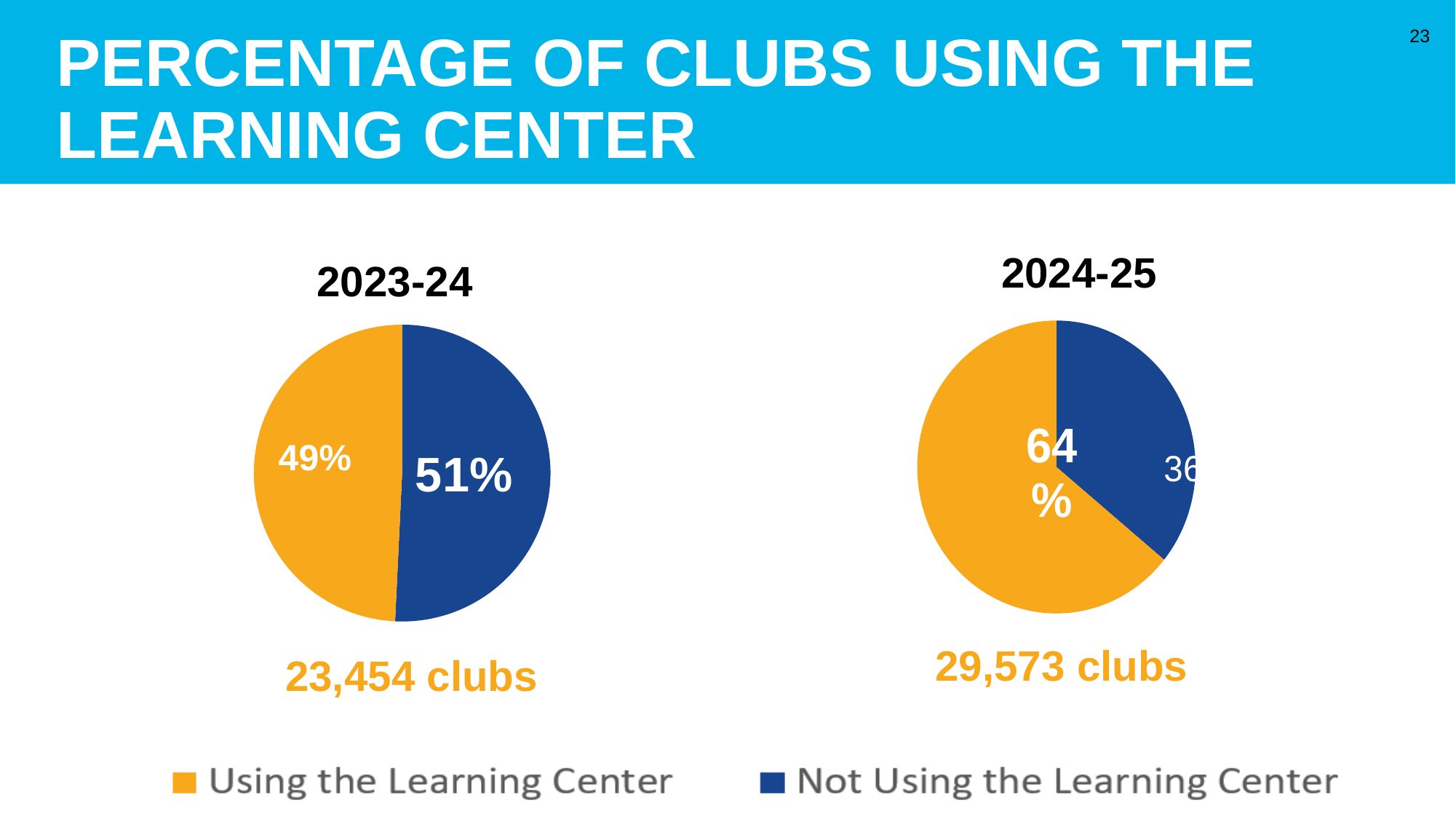
In the 2024-25 pie chart, which slice is larger: Using the Learning Center or Not Using the Learning Center? Using the Learning Center How many categories does the legend list? 2 By how many percentage points did the share of clubs using the Learning Center change from the 2023-24 chart to the 2024-25 chart? 15 percentage points How many clubs are shown below the 2024-25 pie chart? 29,573 clubs In the 2023-24 pie chart, what percentage of clubs were using the Learning Center? 49% What type of chart is used on this slide? Pie chart In the 2024-25 pie chart, what percentage of clubs were using the Learning Center? 64% How many clubs are shown below the 2023-24 pie chart? 23,454 clubs In the 2023-24 pie chart, what percentage of clubs were not using the Learning Center? 51% In the 2023-24 pie chart, which slice is larger: Using the Learning Center or Not Using the Learning Center? Not Using the Learning Center How many pie charts are shown on the slide? 2 Which colour represents clubs using the Learning Center in the pie charts? Orange